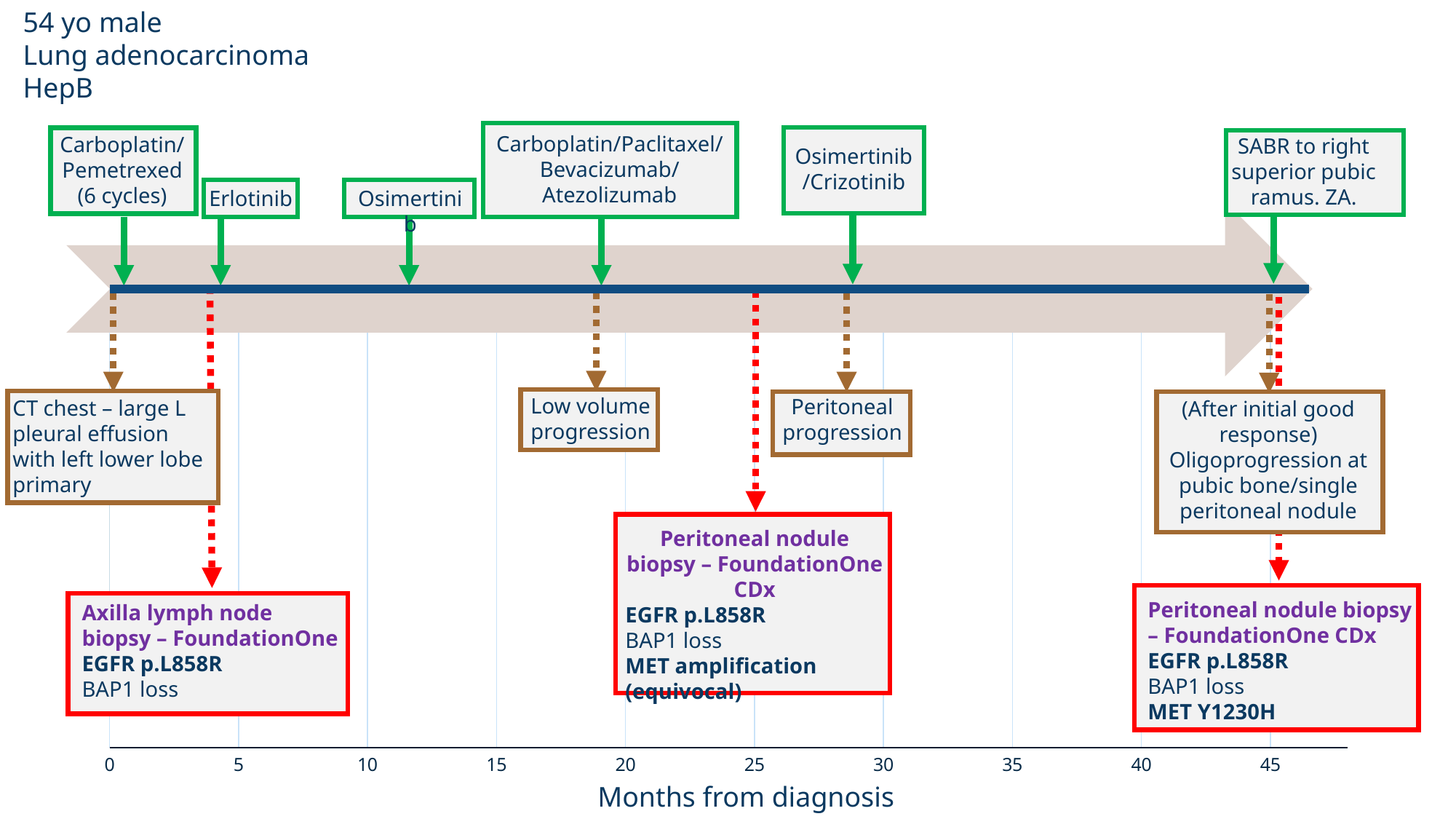
What kind of chart is shown on the slide? Timeline chart Is the low volume progression event greater or less than 20 months from diagnosis? less Which occurred earlier on the timeline, Erlotinib or Osimertinib? Erlotinib Is the start of Osimertinib greater or less than 10 months from diagnosis? greater What is the title of the horizontal axis? Months from diagnosis Is the start of Erlotinib greater or less than 5 months from diagnosis? less Which treatment is the first on the timeline? Carboplatin/Pemetrexed (6 cycles) How many treatment boxes (green) are shown above the timeline? 6 How many biopsy result boxes (red) are shown below the timeline? 3 What is the highest tick value shown on the months axis? 45 Which treatment is the last on the timeline? SABR to right superior pubic ramus. ZA.